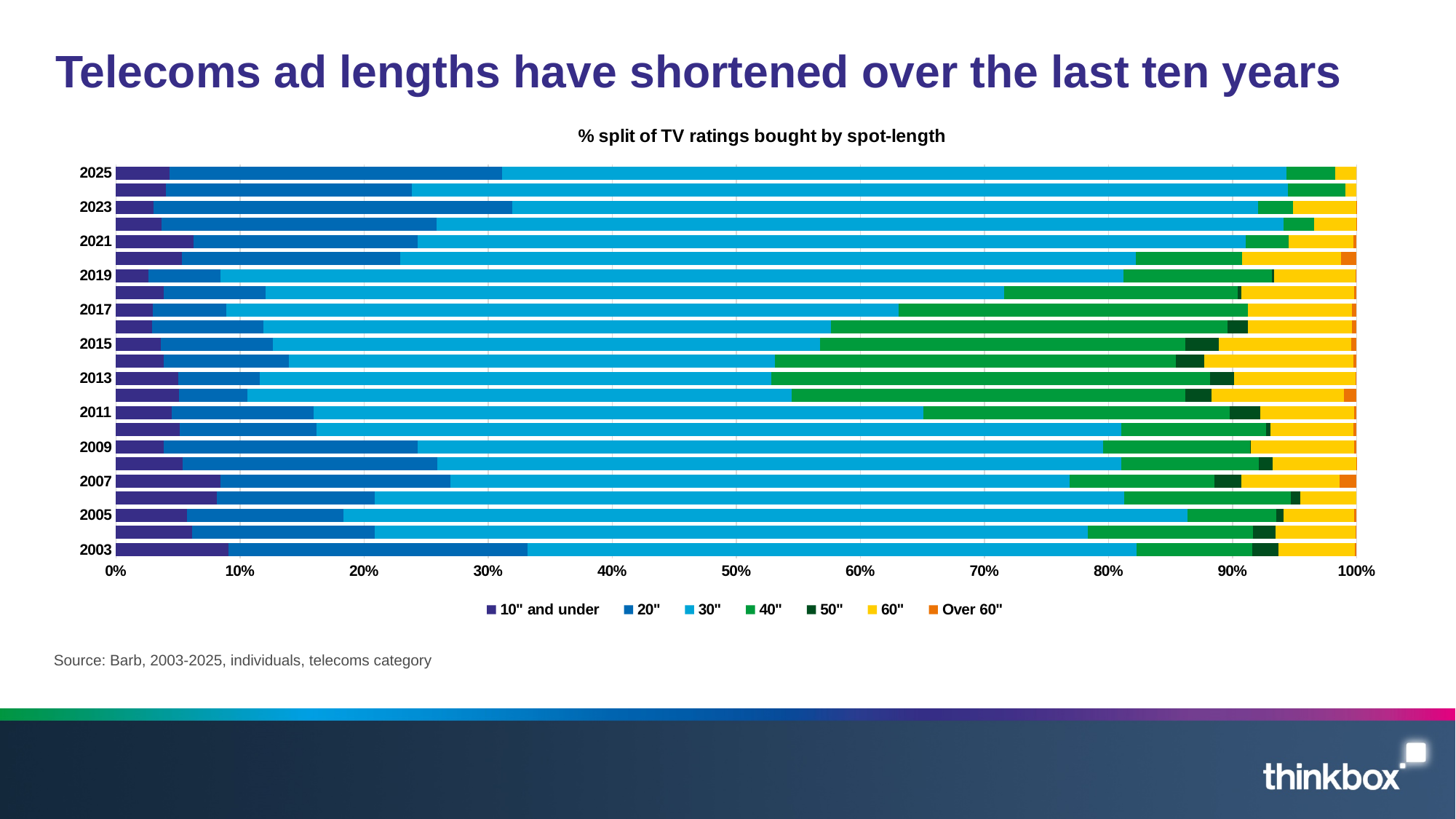
What kind of chart is shown on the slide? Stacked bar chart Does the share of 40" ads rise or fall from 2015 to 2025? fall Which year has the larger share of 30" ads, 2019 or 2015? 2019 Which spot-length series is shown in yellow? 60" Is the combined share of 10" and under, 20" and 30" ads in 2017 greater or less than 70%? less Which year has the larger share of 10" and under ads, 2003 or 2019? 2003 What is the title of the chart? % split of TV ratings bought by spot-length Which year has the larger share of 40" ads, 2013 or 2025? 2013 Is the combined share of 10" and under and 20" ads in 2003 greater or less than 30%? greater Is the share of 10" and under ads in 2003 greater or less than 10%? less Does the share of 30" ads rise or fall from 2013 to 2025? rise How many series does the legend list? 7